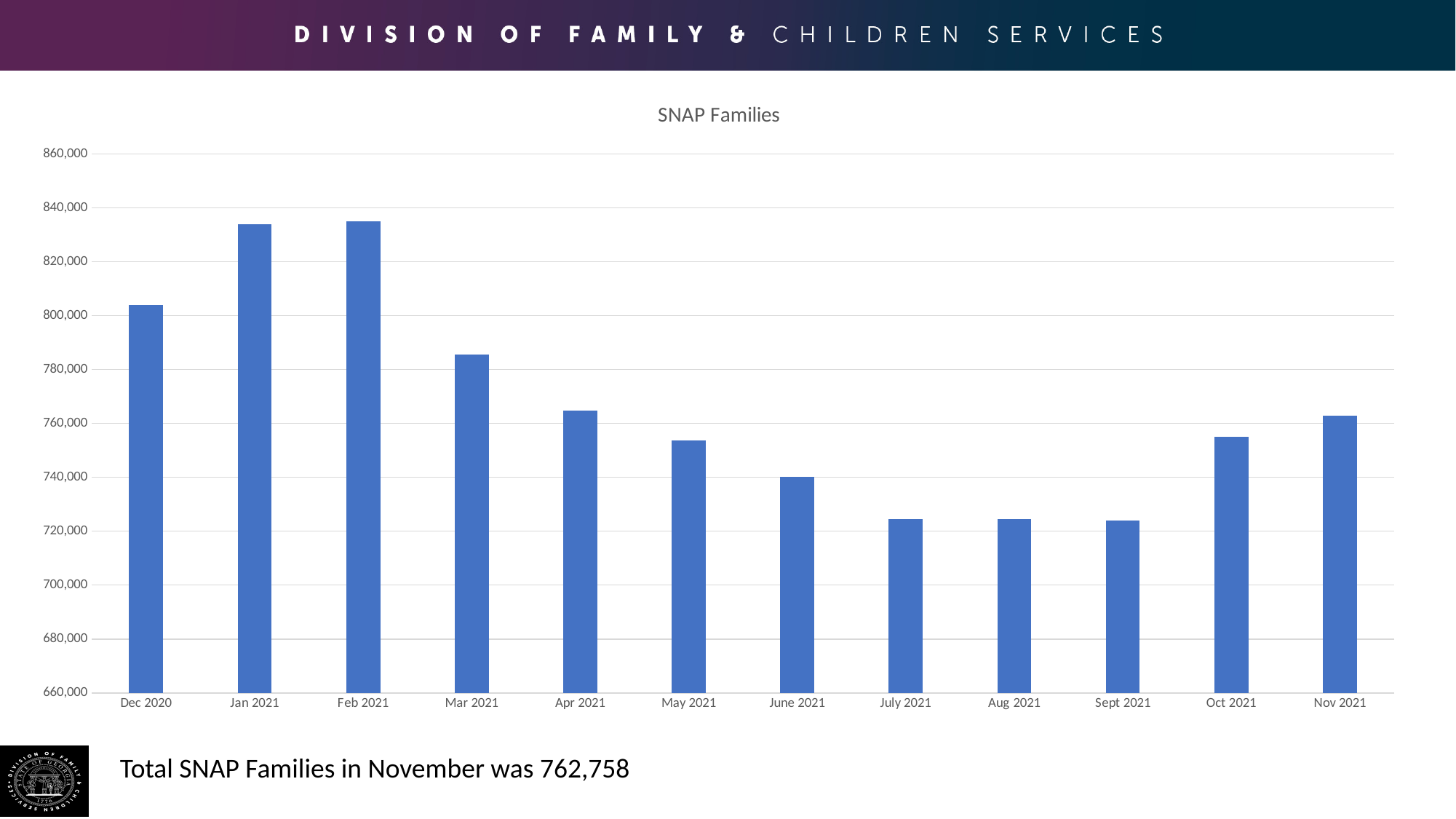
What kind of chart is shown on the slide? Bar chart What is the title of the chart? SNAP Families Do the values rise or fall from Feb 2021 to July 2021? Fall Is the value for June 2021 greater or less than 760,000? less How many months are plotted on the chart? 12 Is the value for Mar 2021 greater or less than 780,000? greater Is the value for July 2021 greater or less than 720,000? greater Which is larger, the value for Mar 2021 or the value for Apr 2021? Mar 2021 Which is larger, the value for Jan 2021 or the value for Dec 2020? Jan 2021 What was the total number of SNAP Families in November 2021? 762,758 What is the lowest value shown on the vertical axis? 660,000